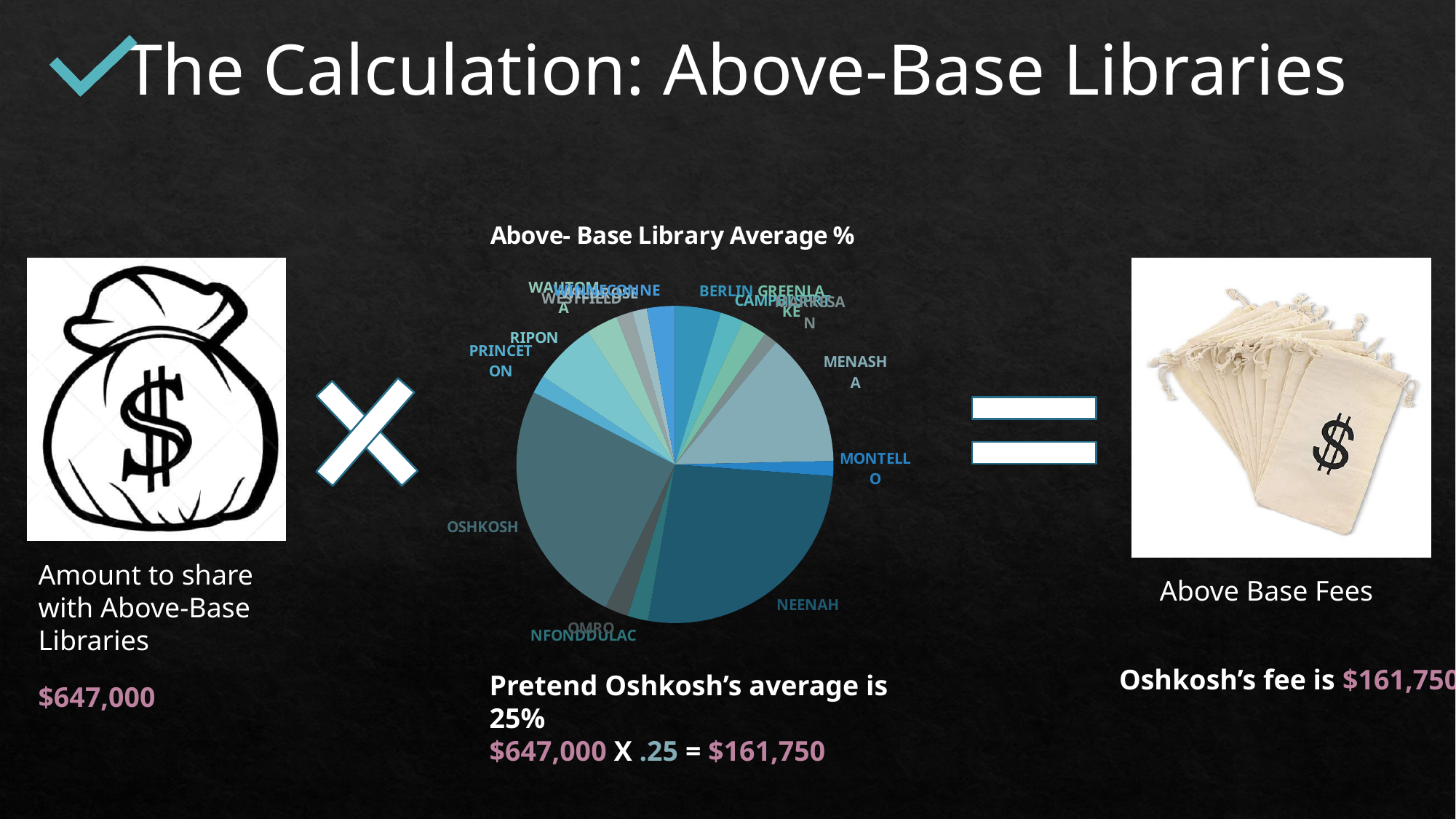
In the pie chart, which slice is larger, MENASHA or MONTELLO? MENASHA What is the title of the pie chart? Above- Base Library Average % In the pie chart, which slice is larger, OSHKOSH or BERLIN? OSHKOSH In the pie chart, which slice is larger, NEENAH or PRINCETON? NEENAH Does the pie chart print percentage values on its slices? No What kind of chart is shown on the slide? pie chart